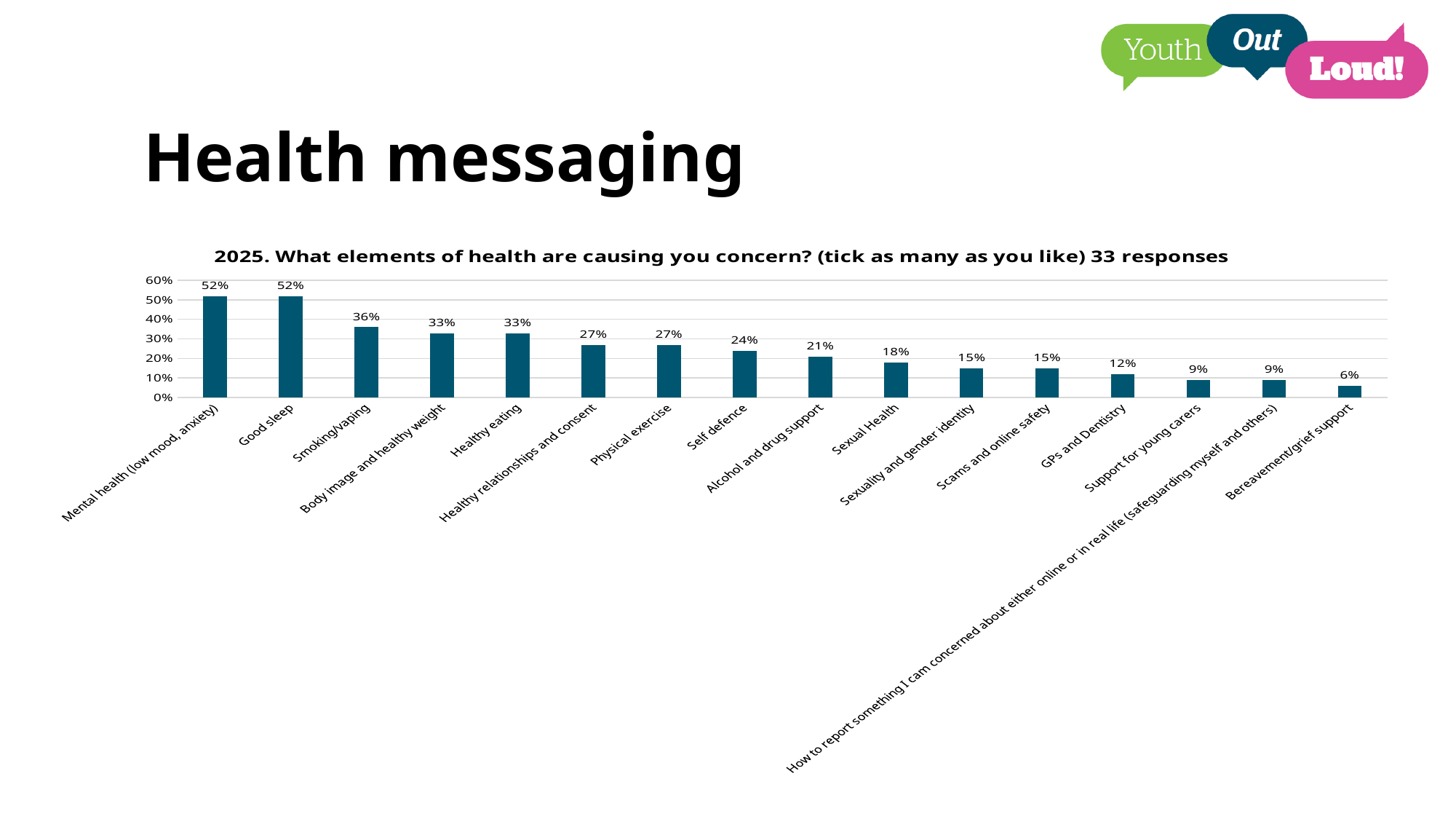
What percentage of respondents selected Smoking/vaping as a health concern? 36% What is the value for Alcohol and drug support? 21% What type of chart is shown on the slide? Bar chart Which is larger, the value for Healthy eating or the value for Scams and online safety? Healthy eating How many categories are shown in the chart? 16 What is the difference between the values for Good sleep and Sexual Health? 34% Is the value for Body image and healthy weight greater or less than 30%? greater What is the difference between the values for Smoking/vaping and Physical exercise? 9% How many responses does the chart title say the survey received? 33 responses Which category has the lowest value in the chart? Bereavement/grief support What is the value shown for Self defence? 24% What percentage is shown for GPs and Dentistry? 12%